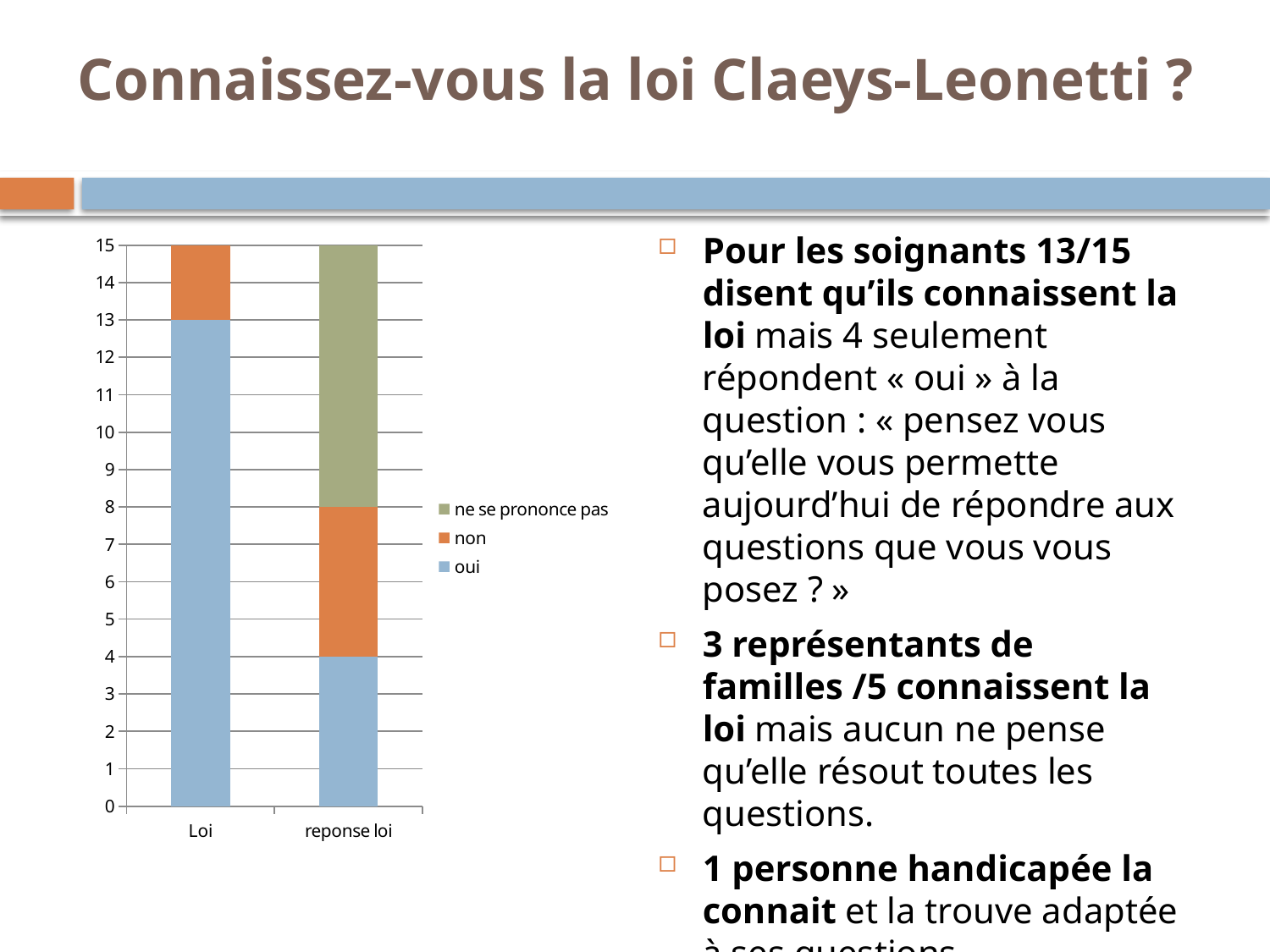
Which category has the larger "ne se prononce pas" segment? reponse loi What is the total height of the "reponse loi" stacked bar? 15 What is the value of the "oui" segment for the "Loi" bar? 13 What kind of chart is shown on the slide? stacked bar chart Is the "oui" value for "reponse loi" greater or less than 5? less Which category has the larger "oui" segment, "Loi" or "reponse loi"? Loi Is the "oui" value for "Loi" greater or less than 10? greater How many categories are shown on the x axis of the chart? 2 What is the total height of the "Loi" stacked bar? 15 How many series does the chart legend list? 3 Which colour represents the "non" series in the chart? orange What is the value of the "oui" segment for the "reponse loi" bar? 4